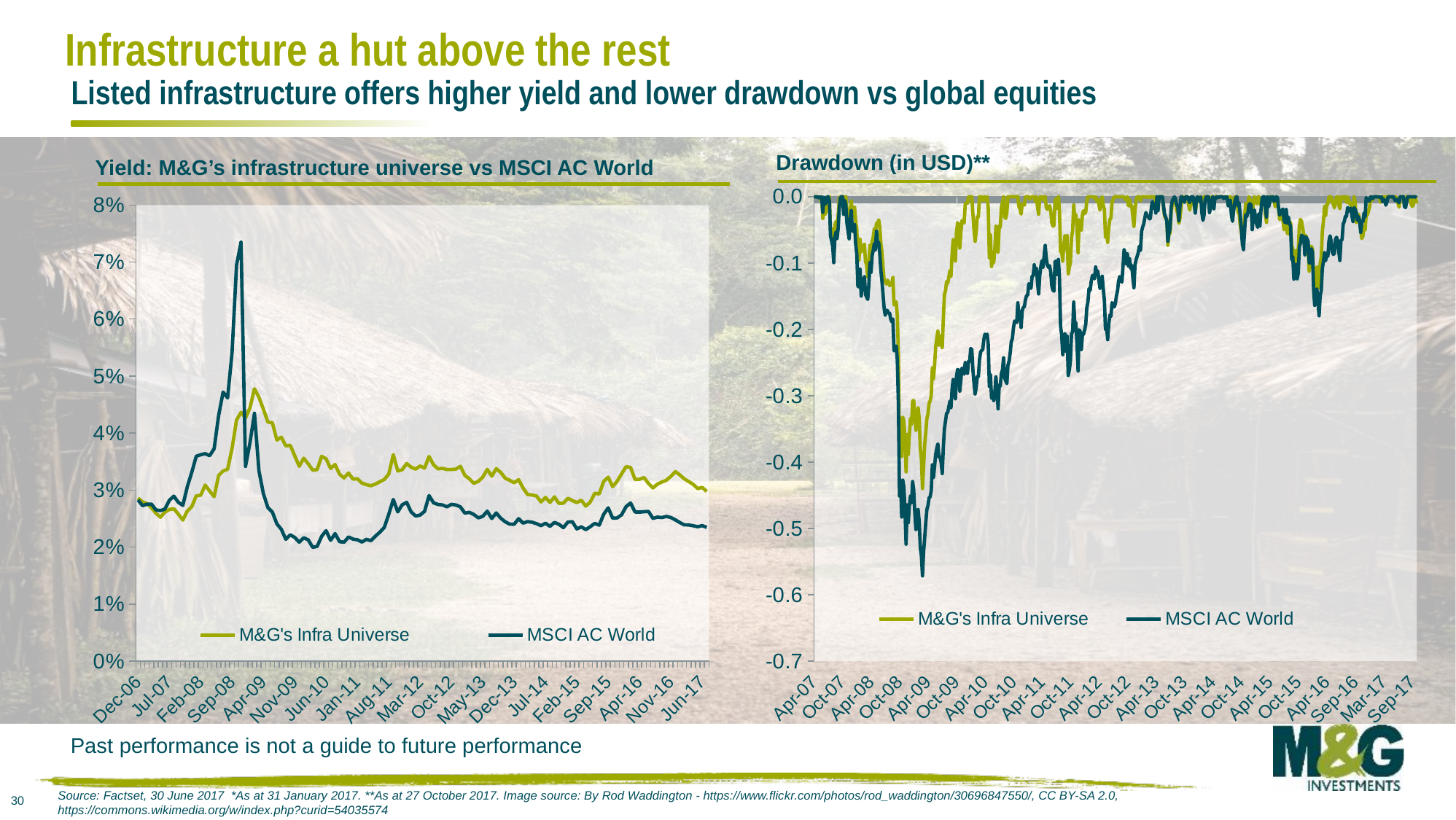
In the 'Yield: M&G's infrastructure universe vs MSCI AC World' chart, which series has the higher yield at Jun-17? M&G's Infra Universe How many series does the legend of the 'Yield: M&G's infrastructure universe vs MSCI AC World' chart list? 2 What is the lowest value shown on the vertical axis of the 'Drawdown (in USD)**' chart? -0.7 In the 'Yield: M&G's infrastructure universe vs MSCI AC World' chart, is the peak yield of M&G's Infra Universe around Apr-09 greater or less than 6%? less In the 'Yield: M&G's infrastructure universe vs MSCI AC World' chart, is the peak yield of MSCI AC World around Sep-08 greater or less than 6%? greater In the 'Drawdown (in USD)**' chart, which series shows the deepest drawdown around Apr-09? MSCI AC World In the 'Drawdown (in USD)**' chart, is the lowest drawdown of M&G's Infra Universe greater or less than -0.5? greater What kind of chart is the 'Drawdown (in USD)**' chart? Line chart In the 'Drawdown (in USD)**' chart, which two series are listed in the legend? M&G's Infra Universe and MSCI AC World In the 'Yield: M&G's infrastructure universe vs MSCI AC World' chart, which series reaches the highest yield around Sep-08? MSCI AC World What kind of chart is the 'Yield: M&G's infrastructure universe vs MSCI AC World' chart? Line chart